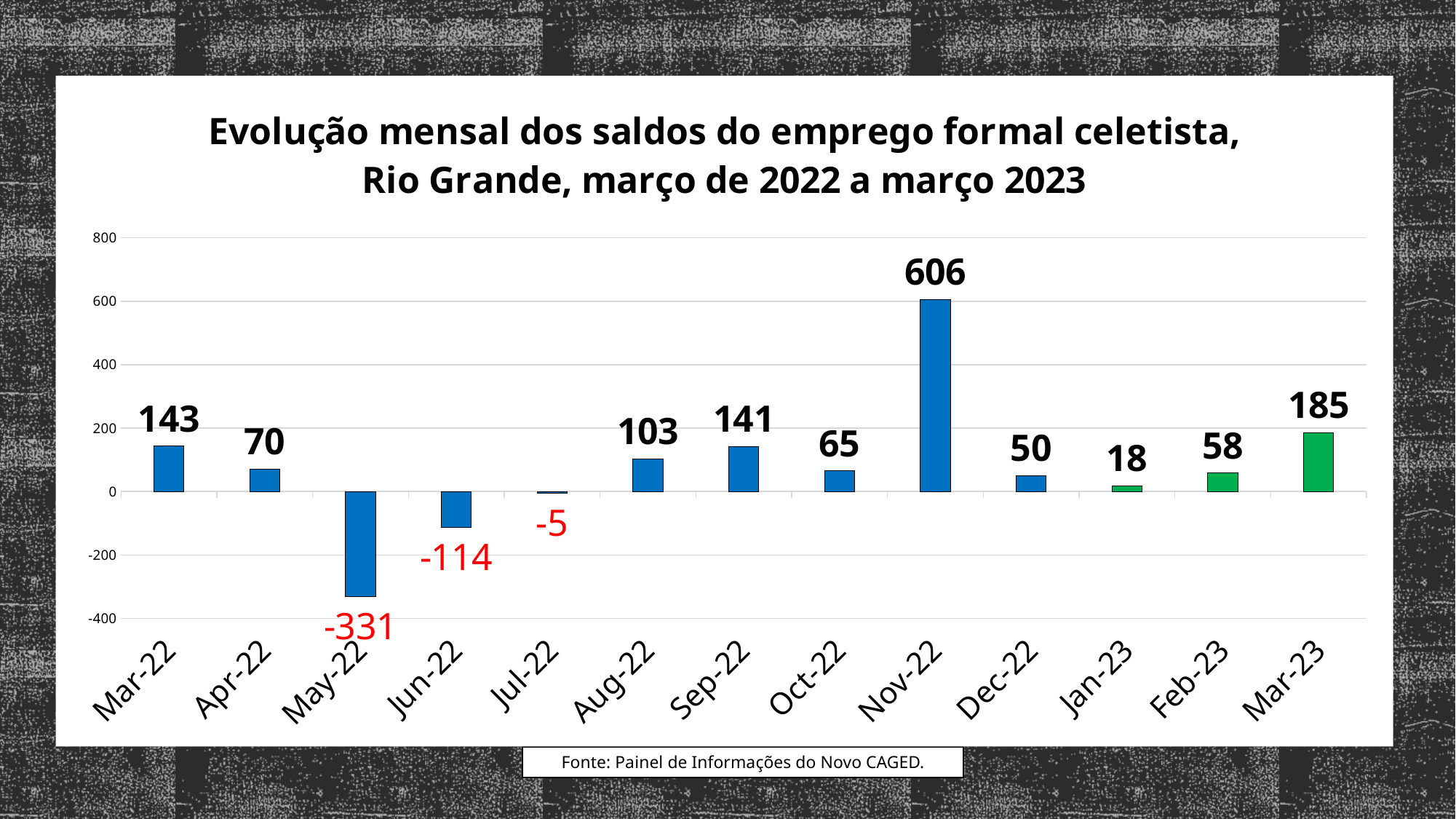
Which is larger, the value for Sep-22 or the value for Aug-22? Sep-22 What kind of chart is shown on the slide? Bar chart What colour are the bars for Jan-23, Feb-23 and Mar-23? Green What is the value for Jan-23? 18 What is the value for Nov-22? 606 How many months have a negative value? 3 Which month has the highest value? Nov-22 What is the value for May-22? -331 How many months are shown on the x axis? 13 Which month has the lowest value? May-22 What is the difference between the values for Jun-22 and Jul-22? 109 What is the difference between the values for Mar-23 and Mar-22? 42